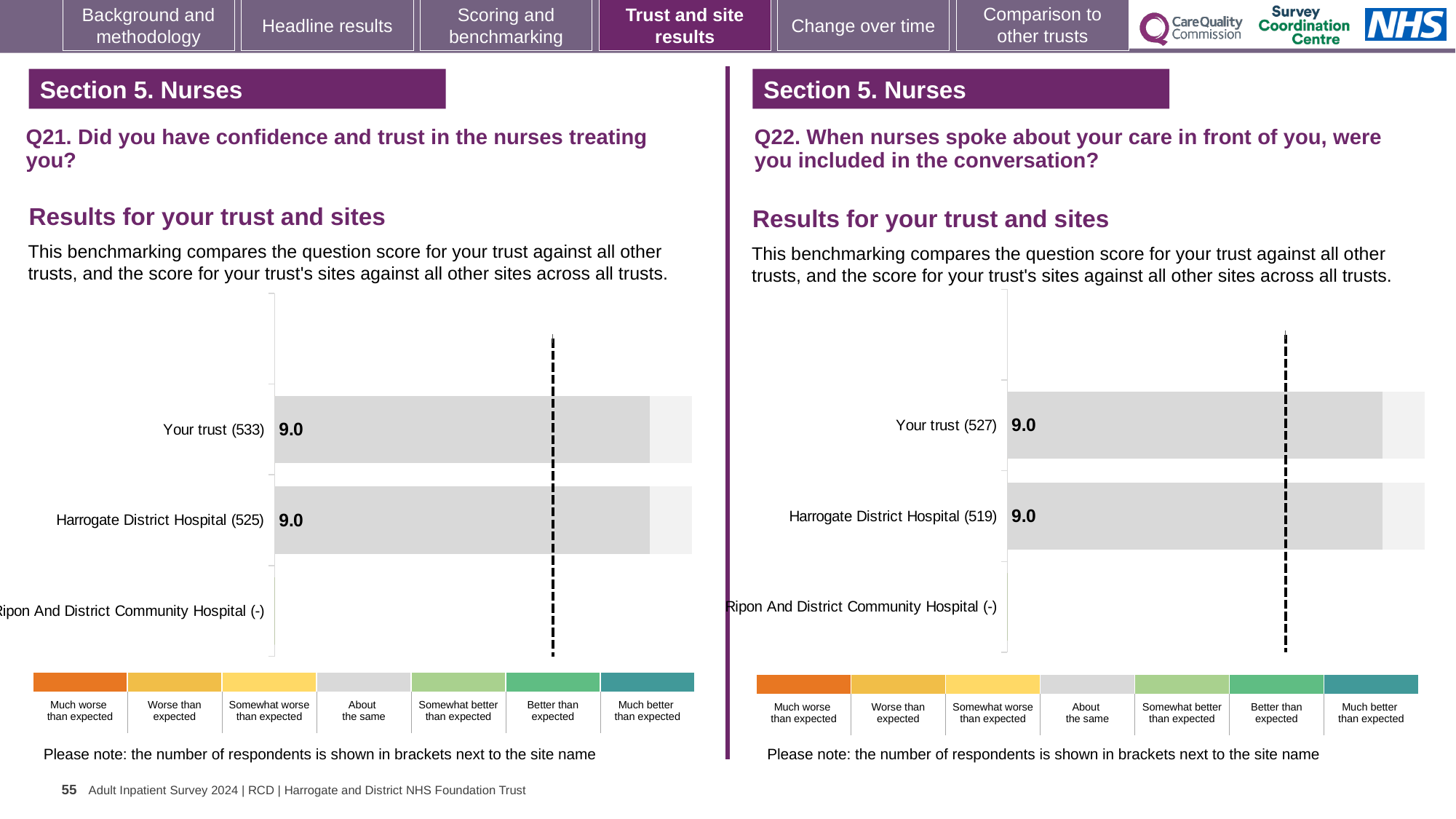
On the Q22 chart (right), what is the score for Harrogate District Hospital? 9.0 On the Q22 chart (right), is the score for Your trust larger than, smaller than, or equal to the score for Harrogate District Hospital? Equal On the Q21 chart (left), how many respondents are shown in brackets for Your trust? 533 On the Q21 chart (left), what is the score for Your trust? 9.0 On the Q22 chart (right), which category has no bar plotted? Ripon And District Community Hospital (-) On the Q22 chart (right), how many respondents are shown in brackets for Harrogate District Hospital? 519 On the Q21 chart (left), what is the difference between the score for Your trust and the score for Harrogate District Hospital? 0.0 On the Q22 chart (right), what is the score for Your trust? 9.0 On the Q22 chart (right), how many categories are listed on the vertical axis? 3 On the Q21 chart (left), what is the score for Harrogate District Hospital? 9.0 On the Q21 chart (left), how many categories are listed on the vertical axis? 3 What kind of chart is the Q21 chart on the left? Bar chart